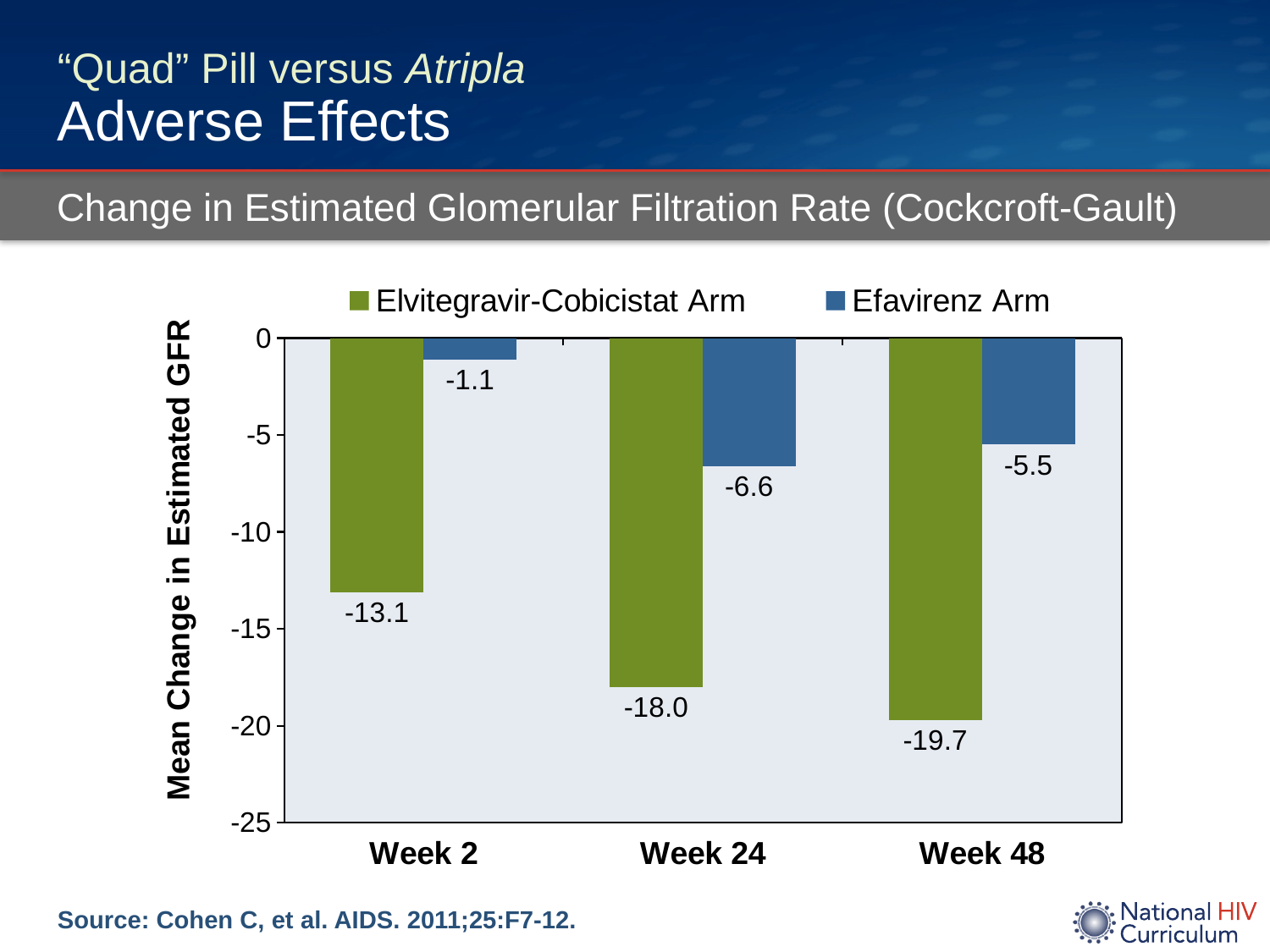
At which week does the Efavirenz Arm show the smallest decrease in estimated GFR? Week 2 What is the label of the y axis? Mean Change in Estimated GFR What is the mean change in estimated GFR for the Efavirenz Arm at Week 48? -5.5 What is the difference between the Elvitegravir-Cobicistat Arm and the Efavirenz Arm values at Week 24? 11.4 What is the mean change in estimated GFR for the Elvitegravir-Cobicistat Arm at Week 2? -13.1 How many series does the legend list? 2 What is the mean change in estimated GFR for the Elvitegravir-Cobicistat Arm at Week 48? -19.7 How many time points are shown on the x axis? 3 What is the mean change in estimated GFR for the Efavirenz Arm at Week 24? -6.6 Which arm has the larger decrease in estimated GFR at Week 48? Elvitegravir-Cobicistat Arm At which week does the Elvitegravir-Cobicistat Arm show the largest decrease in estimated GFR? Week 48 What kind of chart is shown on the slide? Bar chart